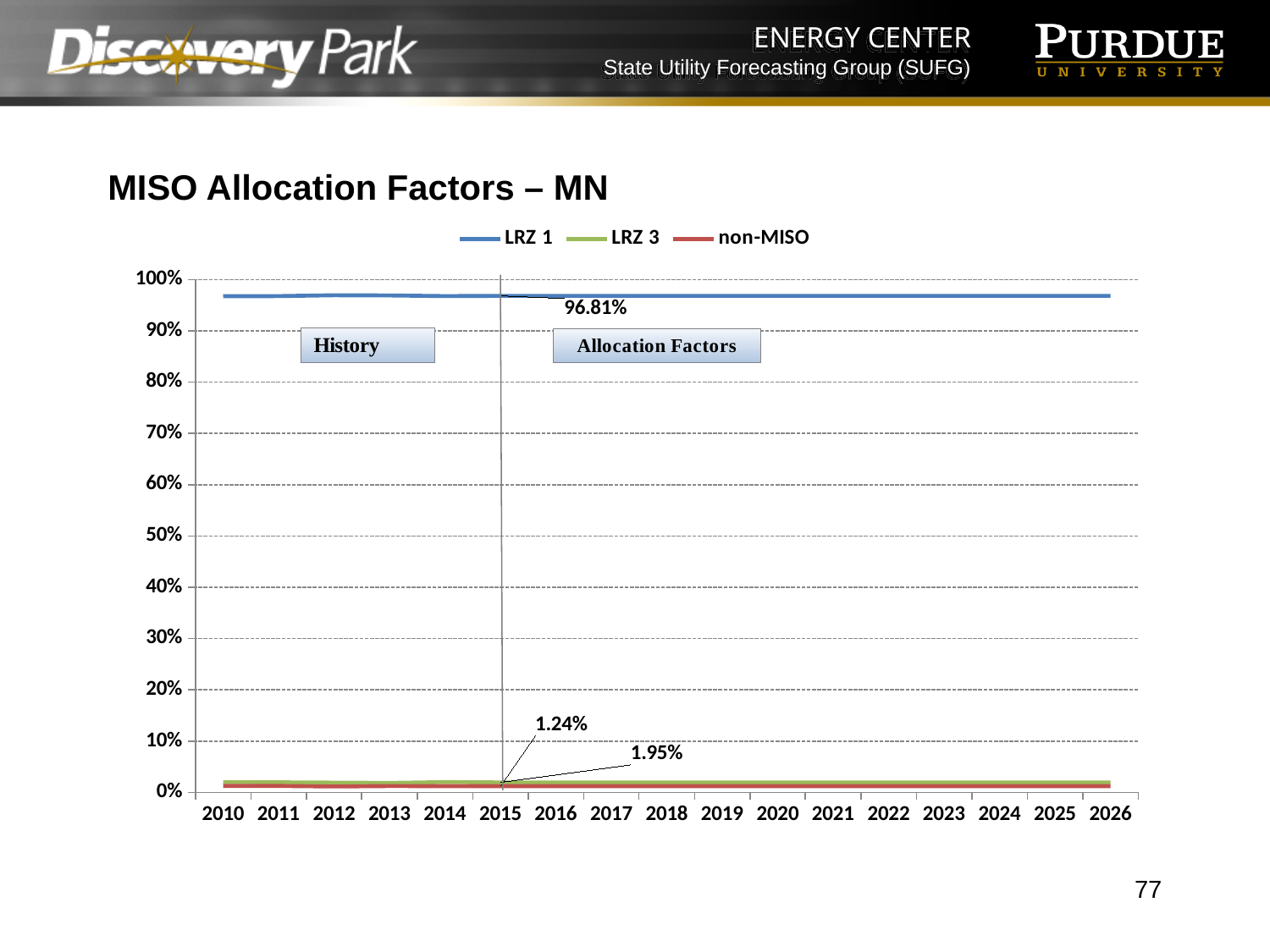
How many series does the legend list? 3 Which series has the highest values across the chart? LRZ 1 Which series are listed in the legend? LRZ 1, LRZ 3, non-MISO What is the title of the chart? MISO Allocation Factors – MN Does the LRZ 1 line rise, fall, or stay roughly flat from 2010 to 2026? roughly flat Is the value for LRZ 1 in 2020 greater or less than 90%? greater How many years are shown on the x axis? 17 What kind of chart is shown on the slide? line chart Is the value for LRZ 3 in 2010 greater or less than 10%? less What is the labelled value for LRZ 1 in 2015? 96.81% Which is larger in 2026, LRZ 1 or non-MISO? LRZ 1 Is the value for non-MISO in 2026 greater or less than 10%? less